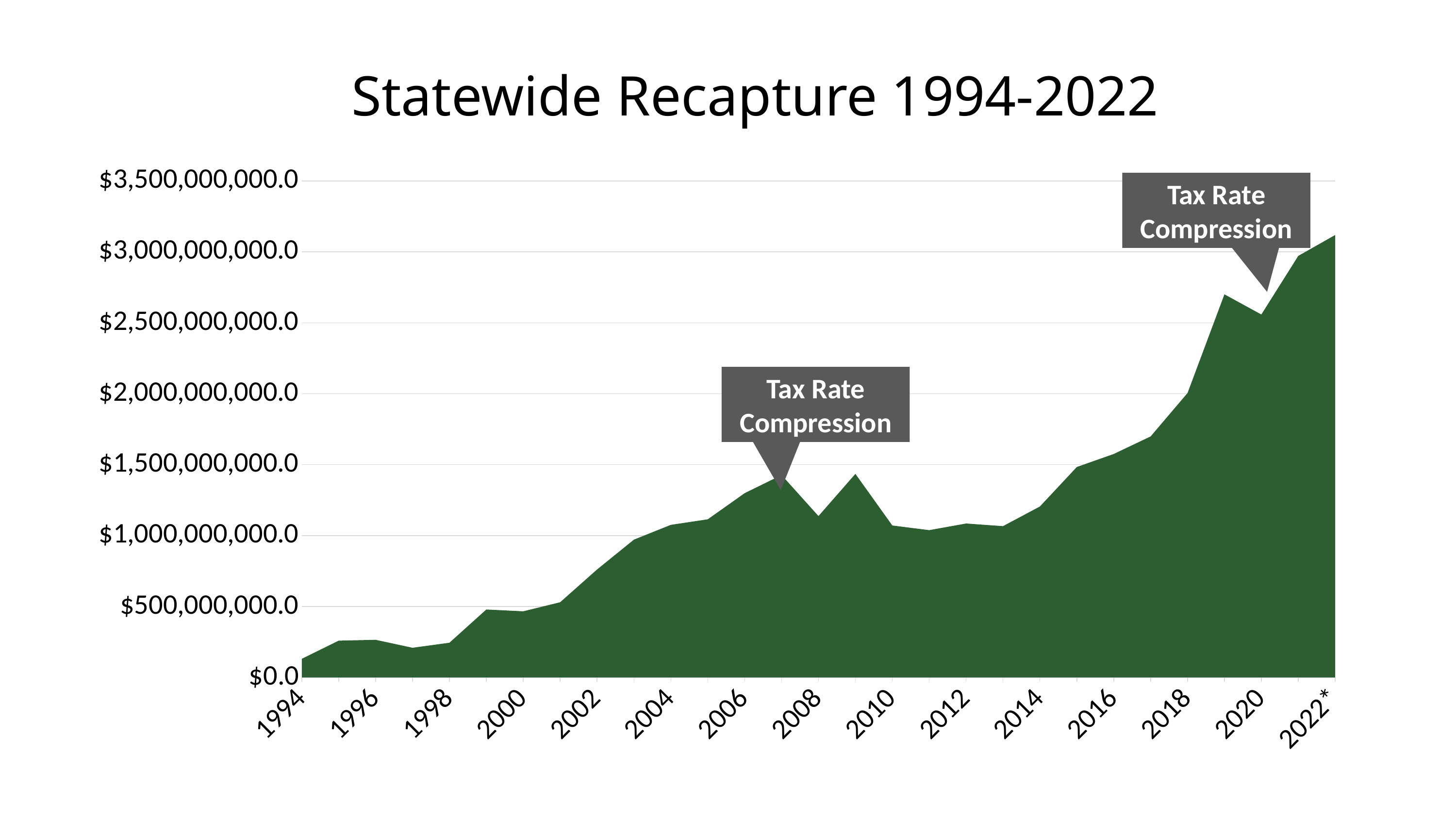
What is the title of the chart? Statewide Recapture 1994-2022 Which year has the larger value, 2019 or 2020? 2019 Overall, do the values rise or fall from 1994 to 2022? rise Is the value for 2008 greater or less than $1,500,000,000.0? less Is the value for 1994 greater or less than $500,000,000.0? less Is the value for 2022* greater or less than $3,000,000,000.0? greater Which year has the lowest statewide recapture value? 1994 What text appears in the two callout boxes on the chart? Tax Rate Compression What kind of chart is shown on the slide? area chart Which year has the highest statewide recapture value? 2022*